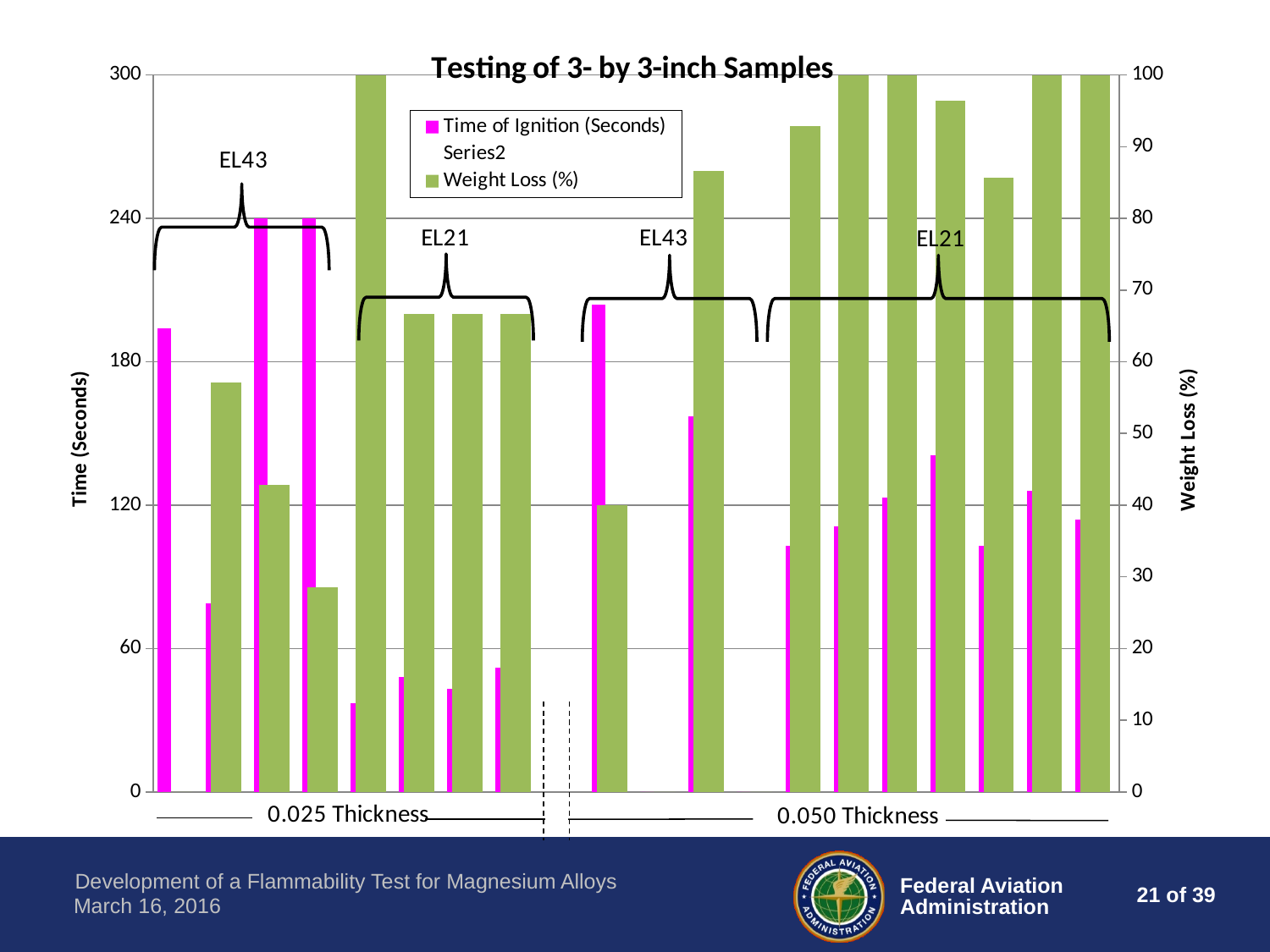
How many series does the legend list? 3 What is the maximum value shown on the left-hand Time (Seconds) axis? 300 What is the maximum value shown on the right-hand Weight Loss (%) axis? 100 At 0.025 Thickness, which alloy shows higher Weight Loss values, EL43 or EL21? EL21 What type of chart is shown on the slide? bar chart How many Weight Loss bars reach 100% on the chart? 5 What is the title of the chart? Testing of 3- by 3-inch Samples What is the label of the right-hand vertical axis? Weight Loss (%) Is the Time of Ignition for the first EL21 sample at 0.025 Thickness greater or less than 60 seconds? less How many thickness groups are shown along the x axis? 2 Is the Time of Ignition for the first EL43 sample at 0.025 Thickness greater or less than 180 seconds? greater